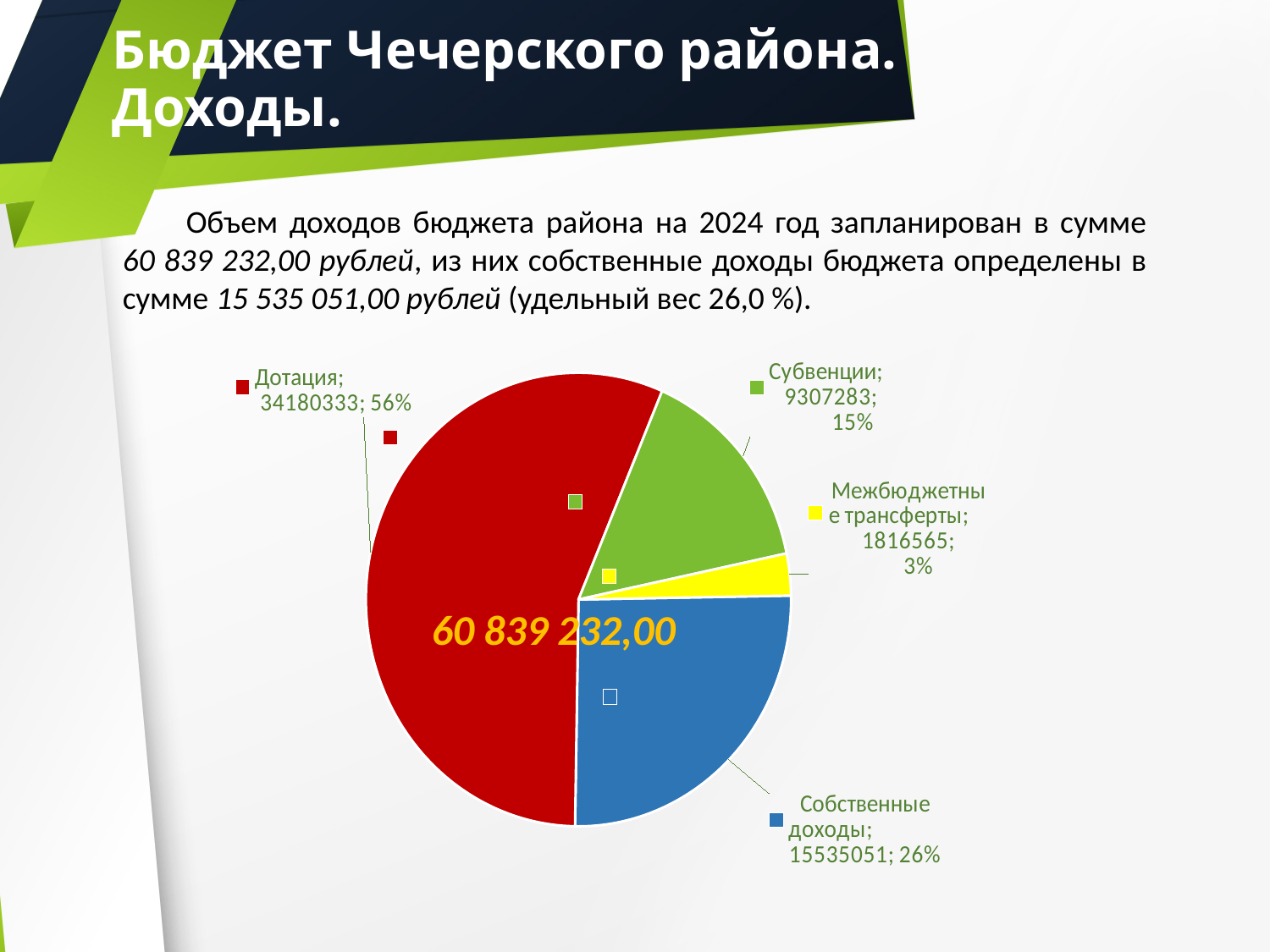
What type of chart is shown on the slide? pie chart Which category has the smallest slice in the pie chart? Межбюджетные трансферты How many slices does the pie chart have? 4 Which is larger, the value for Субвенции or the value for Собственные доходы? Собственные доходы Which category has the largest slice in the pie chart? Дотация What colour is the slice for Собственные доходы? blue What percentage share does Межбюджетные трансферты have in the pie chart? 3% What is the value shown for Дотация? 34180333 What is the difference between the values for Дотация and Собственные доходы? 18645282 What total value is printed in the centre of the pie chart? 60 839 232,00 What is the value shown for Субвенции? 9307283 What percentage share does Собственные доходы have in the pie chart? 26%